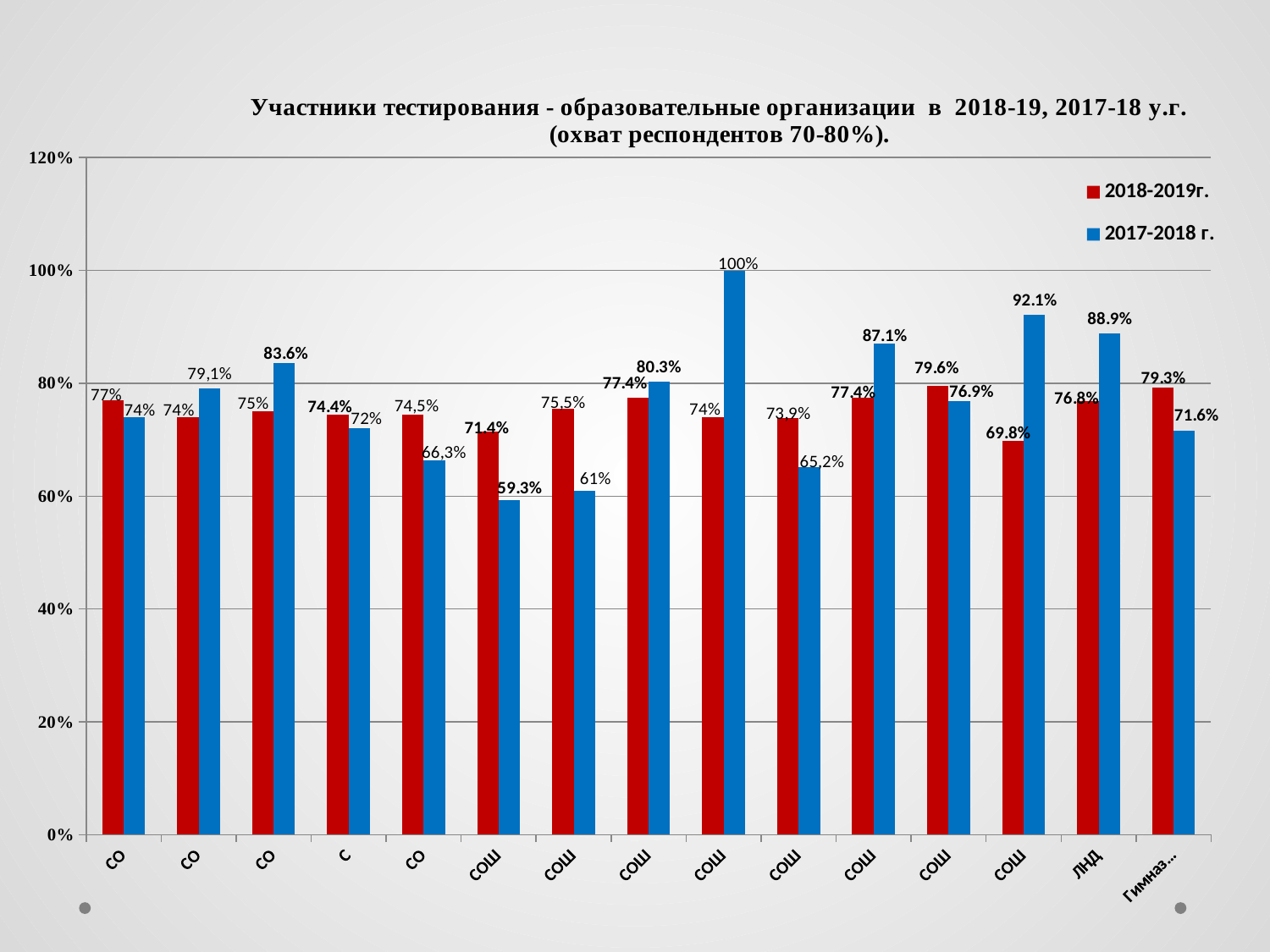
What is the 2017-2018 value for ЛНД? 88.9% How many categories are plotted along the x axis? 15 What is the 2018-2019 value for the category labelled С (fourth from the left)? 74.4% For ЛНД, which series has the larger value, 2018-2019 or 2017-2018? 2017-2018 How many series does the legend list? 2 Which colour represents the 2018-2019 series in the legend? red What is the highest value in the 2017-2018 series? 100% What is the lowest value in the 2017-2018 series? 59.3% What is the lowest value in the 2018-2019 series? 69.8% What kind of chart is shown on the slide? bar chart What is the 2018-2019 value for ЛНД? 76.8% What is the 2017-2018 value for the category labelled С (fourth from the left)? 72%